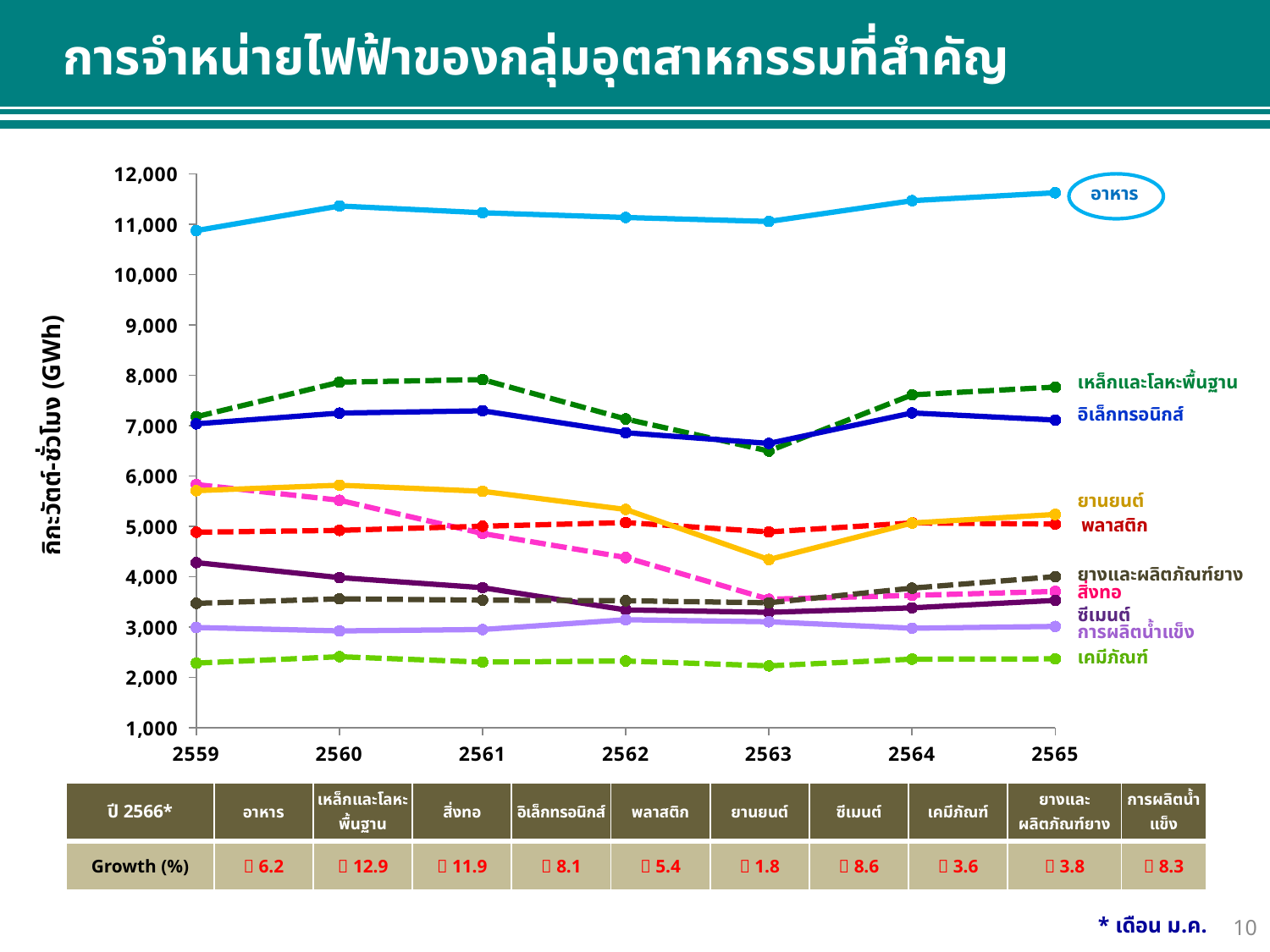
Is the value for อาหาร in 2559 greater or less than 10,000? greater What kind of chart is shown on the slide? line chart Is the value for ยานยนต์ in 2563 greater or less than 5,000? less Which industry group has the highest electricity sales across all years shown? อาหาร In 2565, which is larger: เหล็กและโลหะพื้นฐาน or อิเล็กทรอนิกส์? เหล็กและโลหะพื้นฐาน How many years are shown along the x axis of the chart? 7 Does the value for สิ่งทอ rise or fall from 2559 to 2563? fall How many industry groups (series) are plotted on the chart? 10 What is the title of the slide? การจำหน่ายไฟฟ้าของกลุ่มอุตสาหกรรมที่สำคัญ Which industry group has the lowest electricity sales across all years shown? เคมีภัณฑ์ What is the label on the y axis of the chart? กิกะวัตต์-ชั่วโมง (GWh) Is the value for เคมีภัณฑ์ in 2563 greater or less than 3,000? less